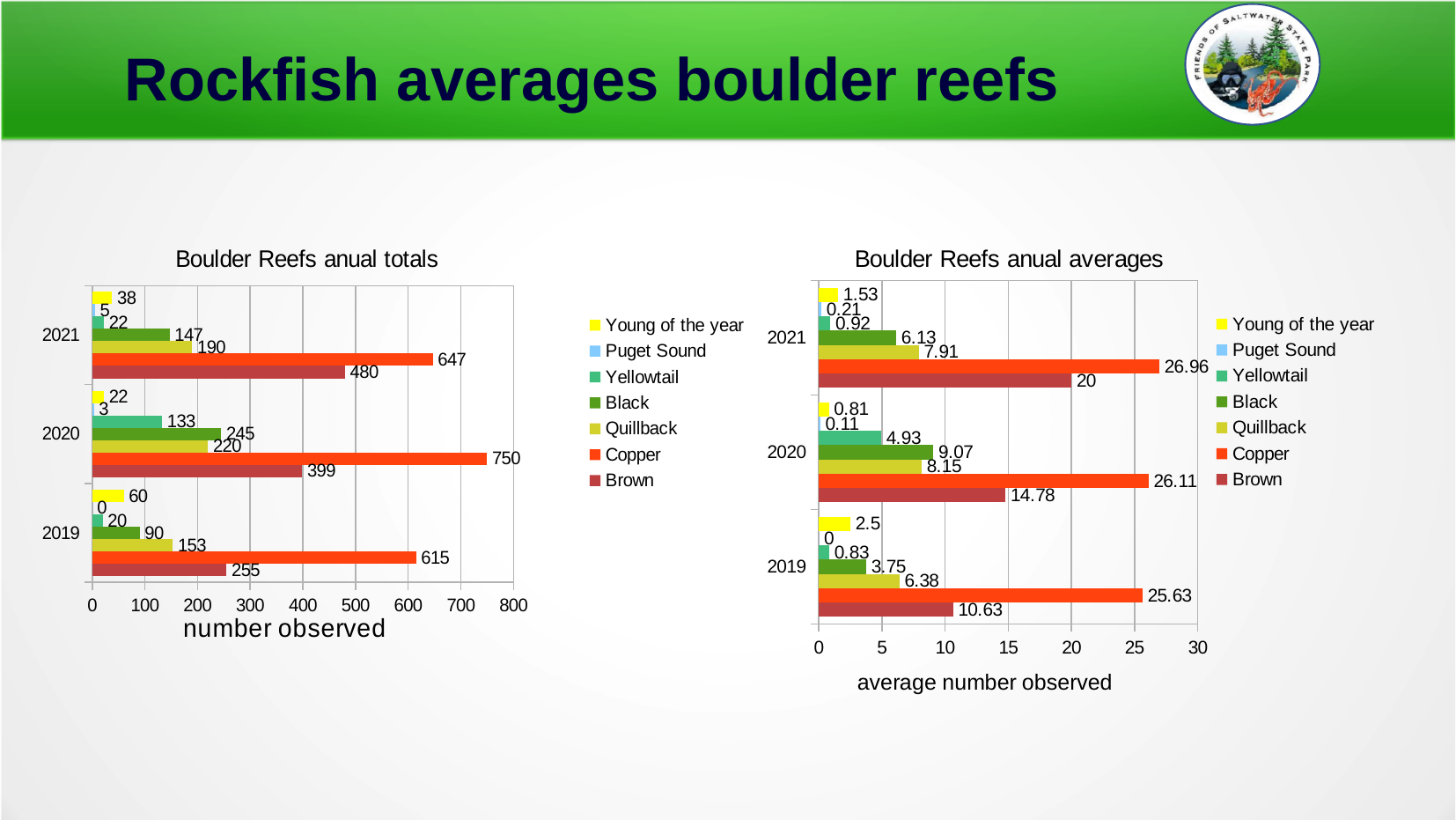
In the 'Boulder Reefs anual totals' chart, what is the value for Brown in 2021? 480 What kind of chart is the 'Boulder Reefs anual totals' chart? bar chart In the 'Boulder Reefs anual averages' chart, what is the value for Copper in 2021? 26.96 In the 'Boulder Reefs anual averages' chart, which year has the lowest Brown value? 2019 In the 'Boulder Reefs anual averages' chart, is the Brown value for 2021 greater or less than 15? greater In the 'Boulder Reefs anual totals' chart, what is the value for Copper in 2020? 750 What is the x-axis label of the 'Boulder Reefs anual averages' chart? average number observed In the 'Boulder Reefs anual totals' chart, which year has the highest Copper value? 2020 In the 'Boulder Reefs anual averages' chart, what is the value for Quillback in 2019? 6.38 In the 'Boulder Reefs anual totals' chart, which is larger in 2020: Black or Quillback? Black How many series does the legend of the 'Boulder Reefs anual averages' chart list? 7 In the 'Boulder Reefs anual totals' chart, what is the difference between the Copper and Brown values in 2019? 360